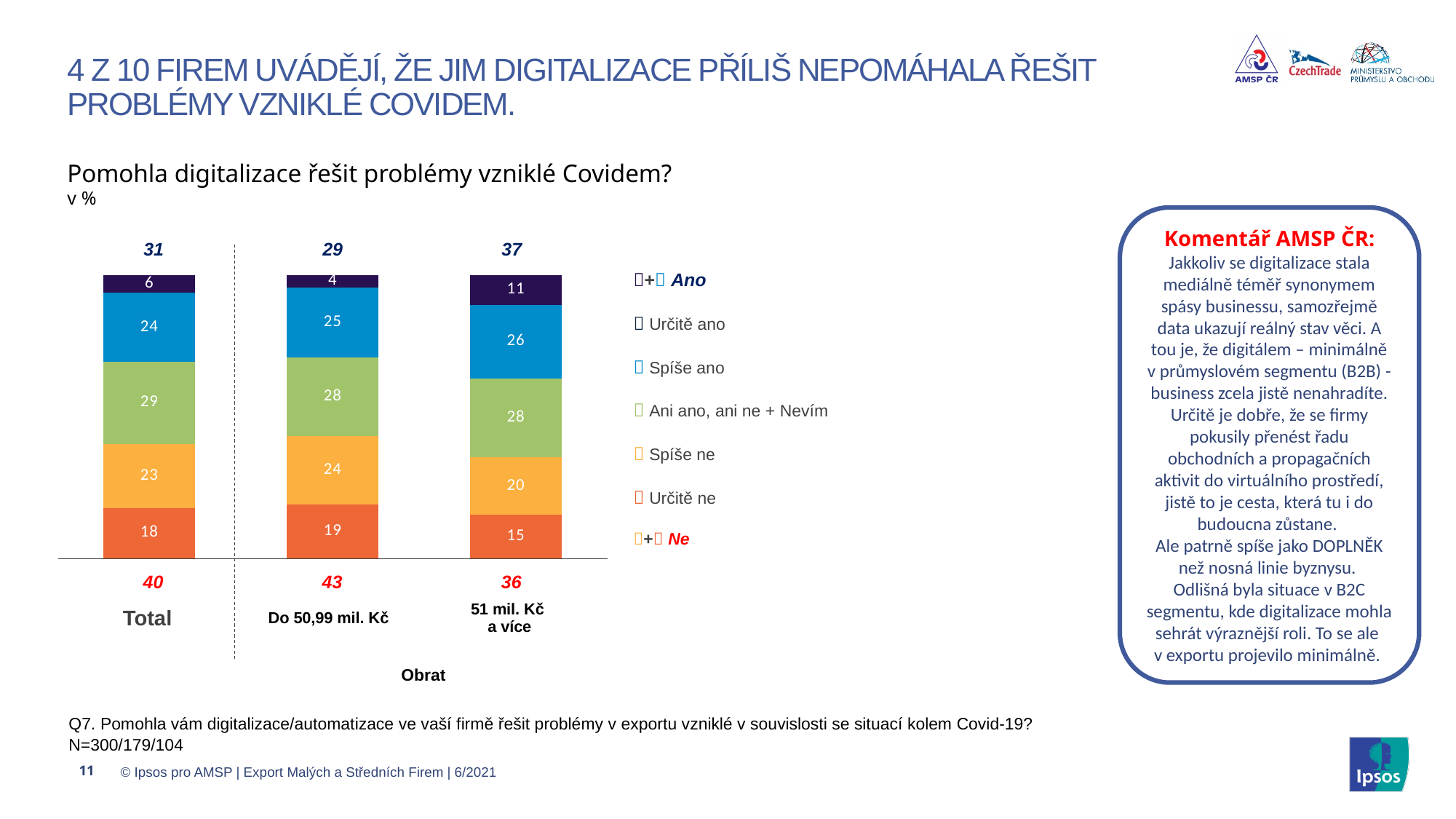
What is the title of the chart? Pomohla digitalizace řešit problémy vzniklé Covidem? What is the value of the 'Určitě ne' segment for the 'Do 50,99 mil. Kč' bar? 19 Which is larger: the 'Ani ano, ani ne + Nevím' value for 'Total' or for 'Do 50,99 mil. Kč'? Total What is the value of the 'Určitě ano' segment for the 'Total' bar? 6 What is the value of the 'Spíše ano' segment for the '51 mil. Kč a více' bar? 26 Which category has the lowest 'Určitě ne' value? 51 mil. Kč a více What is the combined 'Ne' value shown below the 'Do 50,99 mil. Kč' bar? 43 Which category has the highest 'Určitě ano' value? 51 mil. Kč a více What kind of chart is shown on the slide? stacked bar chart What is the difference between the 'Spíše ne' values for 'Do 50,99 mil. Kč' and '51 mil. Kč a více'? 4 How many bars (categories) does the chart show? 3 What is the combined 'Ano' value shown above the '51 mil. Kč a více' bar? 37